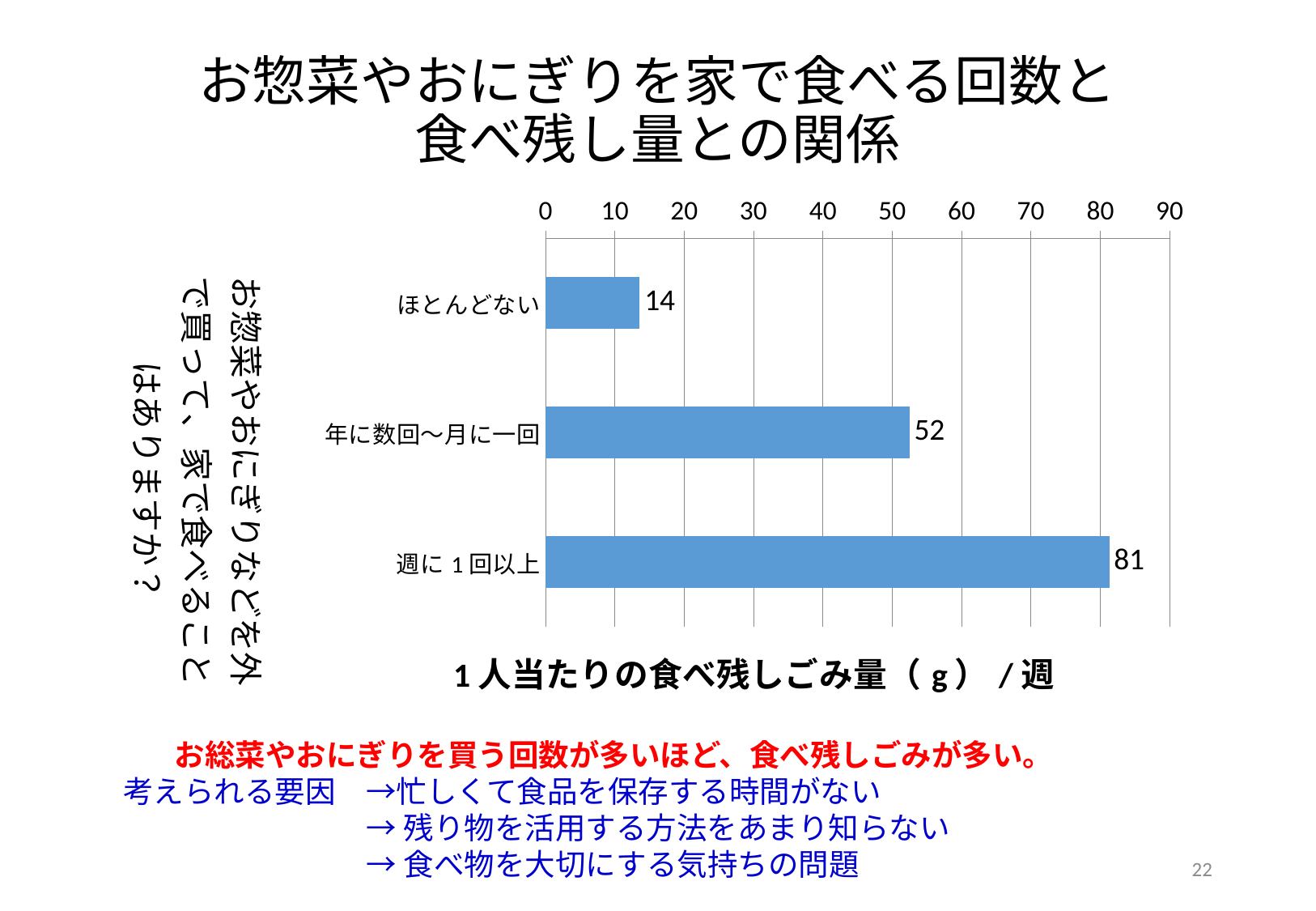
Is the value for 年に数回〜月に一回 greater or less than 50? greater What is the difference between the values for 週に１回以上 and ほとんどない? 67 What is the value for 週に１回以上? 81 What is the value for ほとんどない? 14 Which category has the lowest value? ほとんどない How many categories are shown in the chart? 3 What is the difference between the values for 年に数回〜月に一回 and ほとんどない? 38 Which is larger, the value for 年に数回〜月に一回 or the value for 週に１回以上? 週に１回以上 Which category has the highest value? 週に１回以上 What kind of chart is shown on the slide? bar chart What is the axis title shown below the chart? １人当たりの食べ残しごみ量（ｇ）／週 What is the value for 年に数回〜月に一回? 52